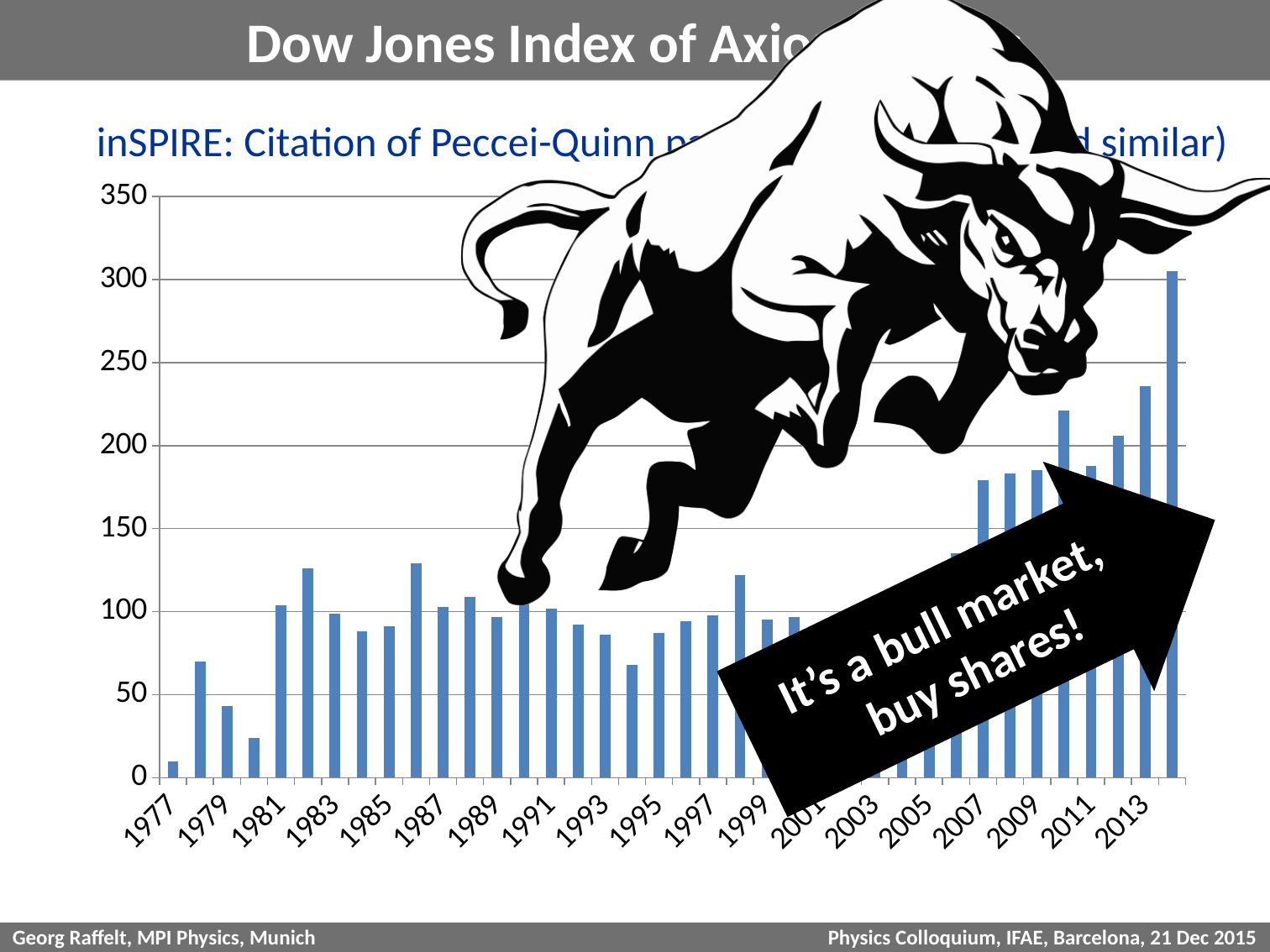
Which year has the larger value, 2011 or 2013? 2013 Do the values generally rise or fall from 2007 to the last bar on the right? rise Is the value for 2013 greater or less than 200? greater Which year has the lowest number of citations? 1977 Is the value for 2009 greater or less than 150? greater Which year has the larger value, 1981 or 1982? 1982 Is the value for 1977 greater or less than 50? less What kind of chart is shown on the slide? bar chart What text is written on the large arrow overlaid on the chart? It's a bull market, buy shares!